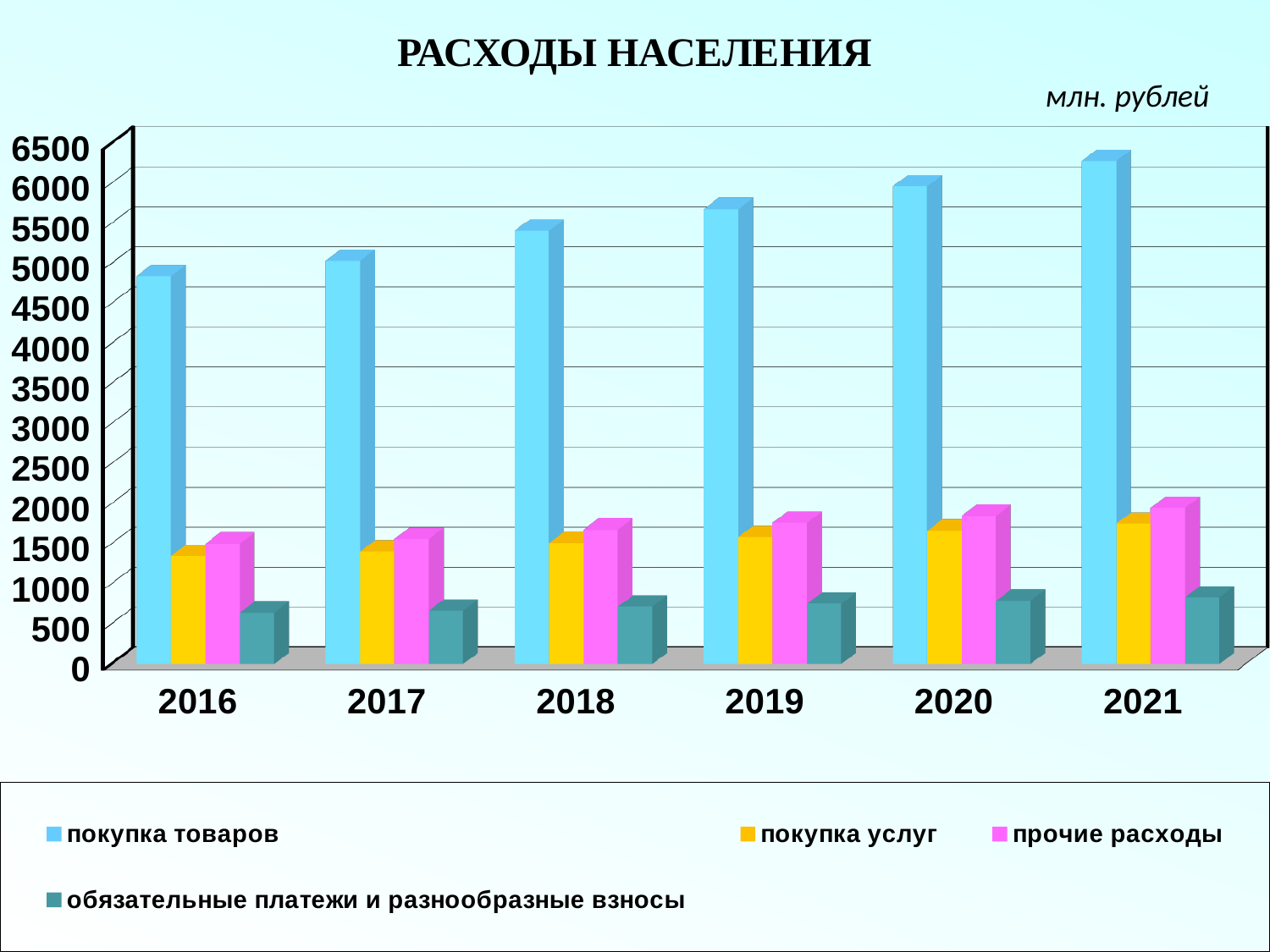
How many series does the legend list? 4 Is the value for прочие расходы in 2021 greater or less than 1500? greater Is the value for обязательные платежи и разнообразные взносы in 2016 greater or less than 1000? less How many years are shown on the x axis? 6 Do the values for покупка товаров rise or fall from 2016 to 2021? rise What kind of chart is shown on the slide? bar chart In which year is the value for покупка товаров highest? 2021 In which year is the value for покупка товаров lowest? 2016 Is the value for покупка товаров in 2016 greater or less than 5000? less What unit of measurement is stated on the slide for the chart values? млн. рублей Which is larger in 2019: покупка услуг or прочие расходы? прочие расходы